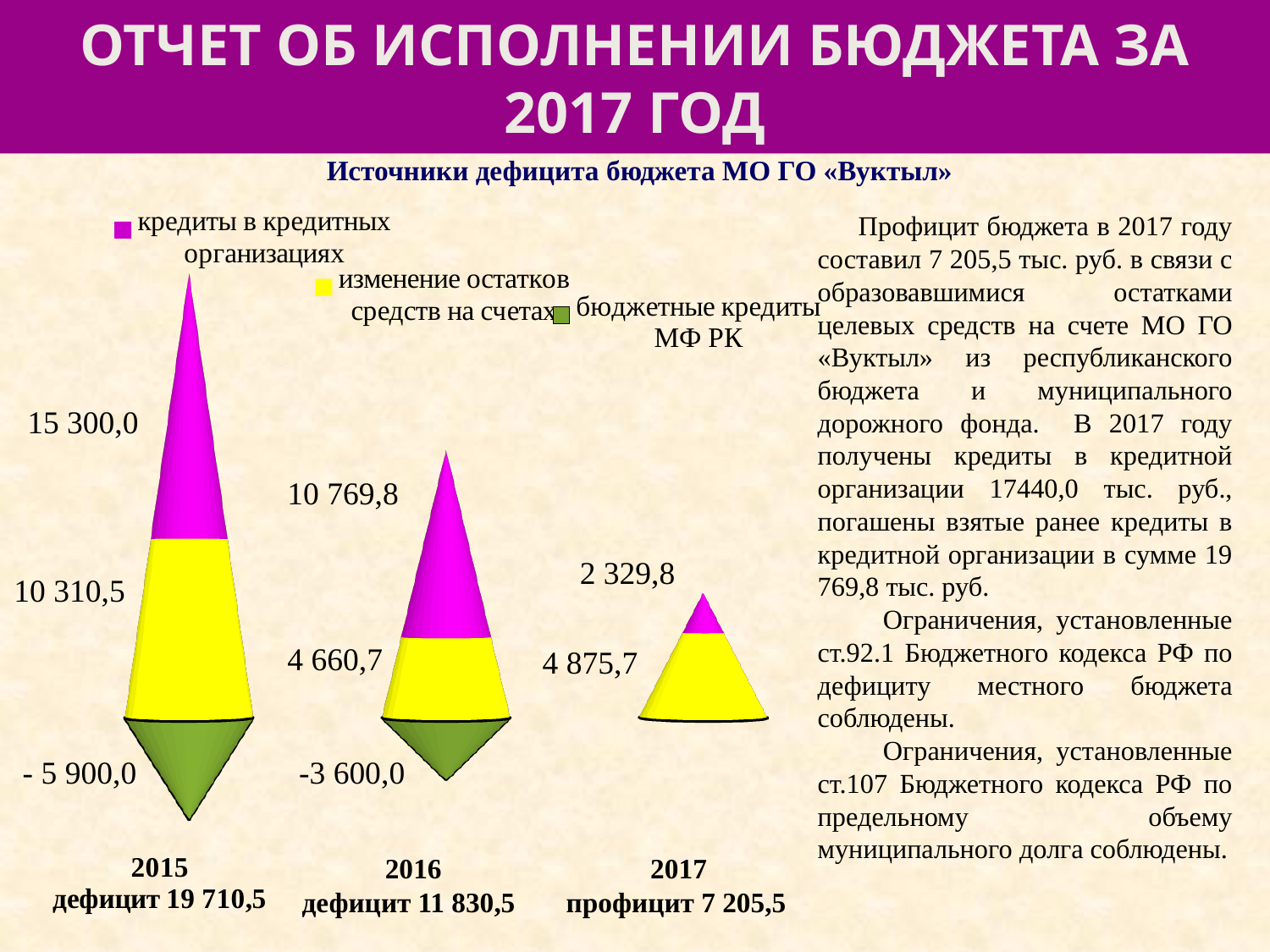
Does the value of «кредиты в кредитных организациях» rise or fall from 2015 to 2017? fall What is the difference between the «кредиты в кредитных организациях» values for 2015 and 2016? 4 530,2 What is the value of «кредиты в кредитных организациях» for 2017? 2 329,8 What is the value of «изменение остатков средств на счетах» for 2017? 4 875,7 How many years are shown on the chart? 3 In which year is the value of «изменение остатков средств на счетах» the lowest? 2016 What is the title of the chart? Источники дефицита бюджета МО ГО «Вуктыл» What is the value of «кредиты в кредитных организациях» for 2015? 15 300,0 How many series does the legend list? 3 Which is larger for 2017: «кредиты в кредитных организациях» or «изменение остатков средств на счетах»? изменение остатков средств на счетах What is the value of «бюджетные кредиты МФ РК» for 2016? -3 600,0 In which year is the value of «кредиты в кредитных организациях» the highest? 2015